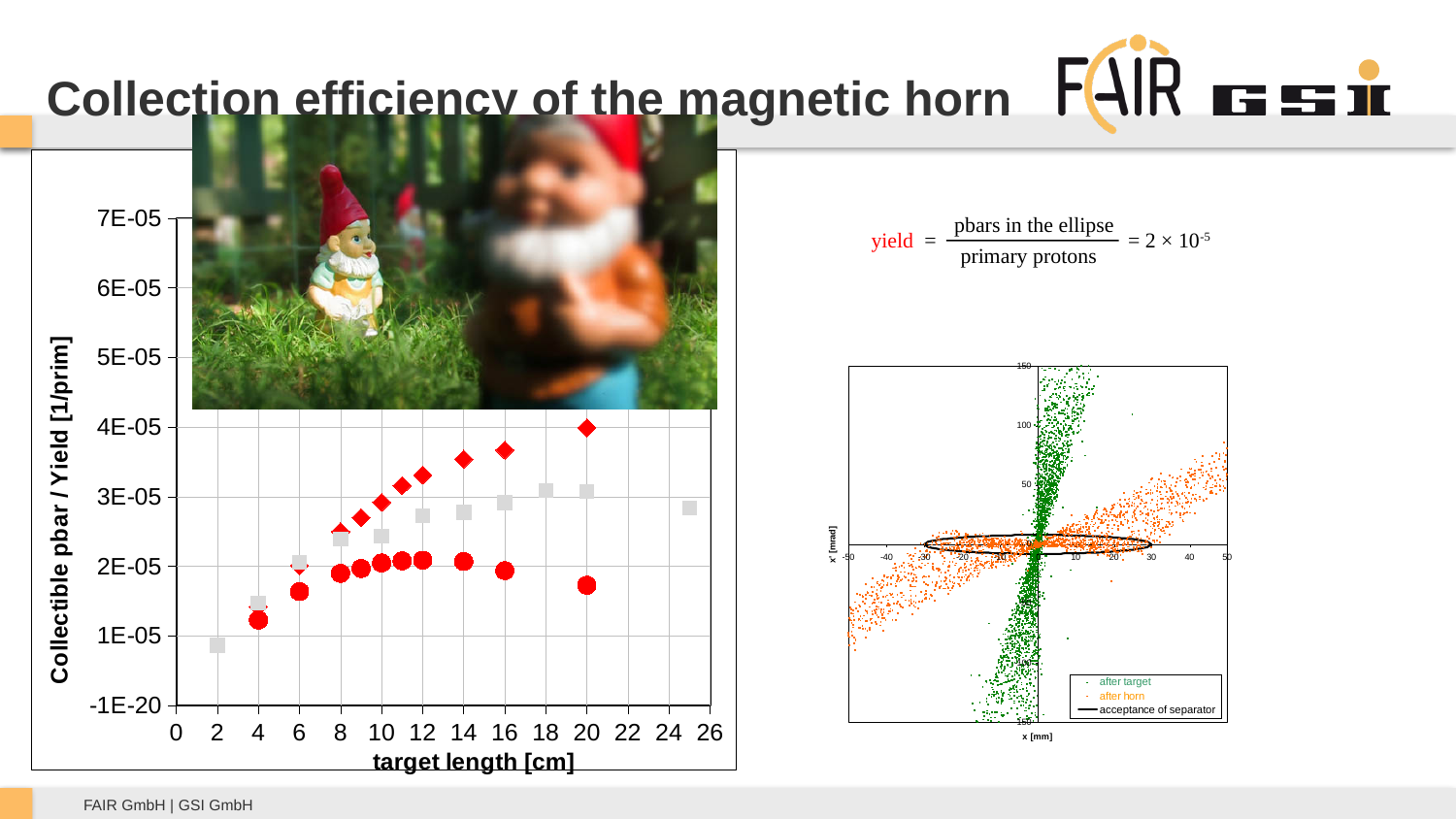
On the left chart, is the value of the red diamond series at a target length of 8 cm greater or less than 2E-05? greater On the left chart, is the value of the red diamond series at a target length of 20 cm greater or less than 3E-05? greater On the left chart, at which target length does the red circle series have its lowest value? 4 On the left chart, what is the title of the vertical axis? Collectible pbar / Yield [1/prim] On the left chart, is the value of the red circle series at a target length of 20 cm greater or less than 2E-05? less What kind of chart is the chart on the right of the slide? scatter chart How many series does the legend of the chart on the right of the slide list? 3 On the left chart, at which target length does the red diamond series reach its highest value? 20 On the left chart, do the values of the red diamond series rise or fall as target length increases? rise What kind of chart is the chart on the left of the slide? scatter chart On the left chart, what is the title of the horizontal axis? target length [cm] On the left chart, at a target length of 16 cm, which series has the larger value: the red diamonds or the red circles? red diamonds